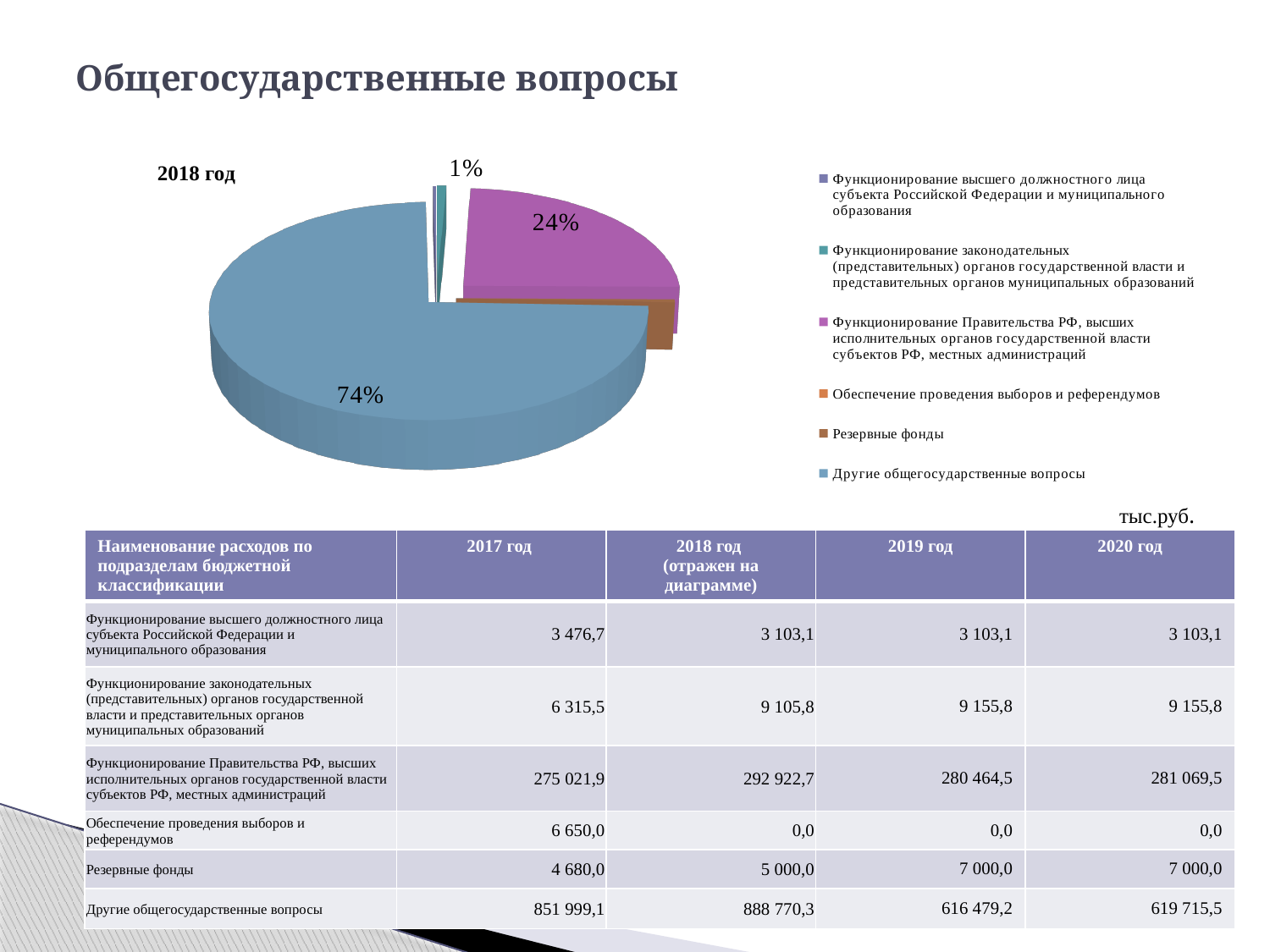
Which year does the pie chart represent, according to its title? 2018 год What colour is the largest slice of the pie chart? blue How many categories does the pie chart's legend list? 6 Which category has the largest slice in the pie chart? Другие общегосударственные вопросы What is the smallest percentage label printed on the pie chart? 1% What kind of chart is shown on the slide? pie chart By how many percentage points does the 74% slice exceed the 24% slice? 50 Which is larger in the pie chart: the slice for Другие общегосударственные вопросы or the slice for Функционирование Правительства РФ? Другие общегосударственные вопросы How many percentage labels are printed on the pie chart? 3 Is the share for Другие общегосударственные вопросы greater or less than 50%? greater What share of the pie is labelled for Функционирование Правительства РФ, высших исполнительных органов государственной власти субъектов РФ, местных администраций? 24% What share of the pie is labelled for Другие общегосударственные вопросы? 74%